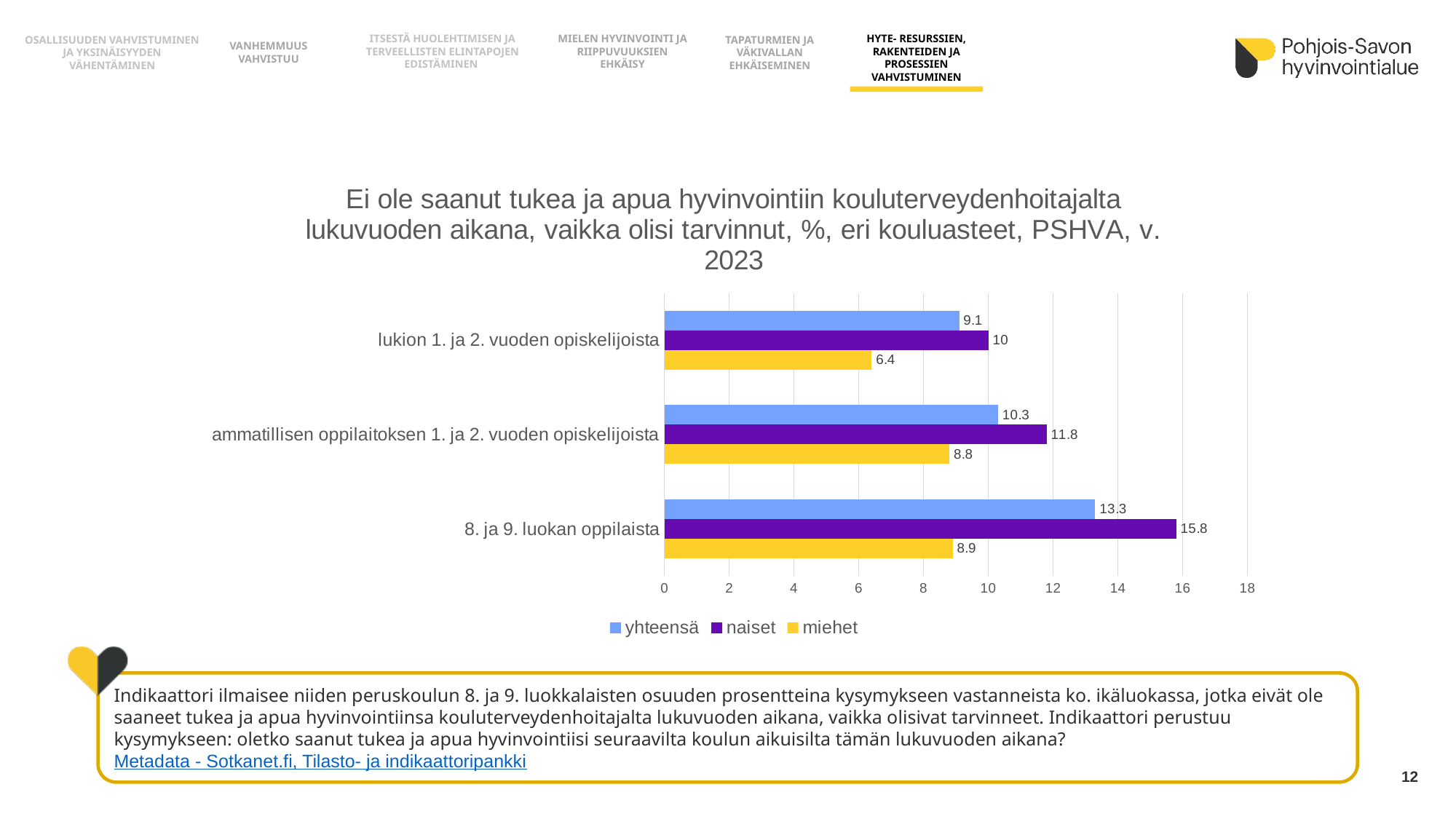
Which category has the highest naiset value? 8. ja 9. luokan oppilaista What is the value for miehet among lukion 1. ja 2. vuoden opiskelijoista? 6.4 What is the yhteensä value for ammatillisen oppilaitoksen 1. ja 2. vuoden opiskelijoista? 10.3 Which category has the lowest miehet value? lukion 1. ja 2. vuoden opiskelijoista Is the naiset value for ammatillisen oppilaitoksen 1. ja 2. vuoden opiskelijoista greater or less than 10? greater How many categories are shown on the chart? 3 Which colour represents the miehet series? yellow How many series does the legend list? 3 What kind of chart is shown on the slide? bar chart What is the difference between the naiset and miehet values for 8. ja 9. luokan oppilaista? 6.9 Which is larger: the yhteensä value for lukion 1. ja 2. vuoden opiskelijoista or for ammatillisen oppilaitoksen 1. ja 2. vuoden opiskelijoista? ammatillisen oppilaitoksen 1. ja 2. vuoden opiskelijoista What is the value for naiset among 8. ja 9. luokan oppilaista? 15.8